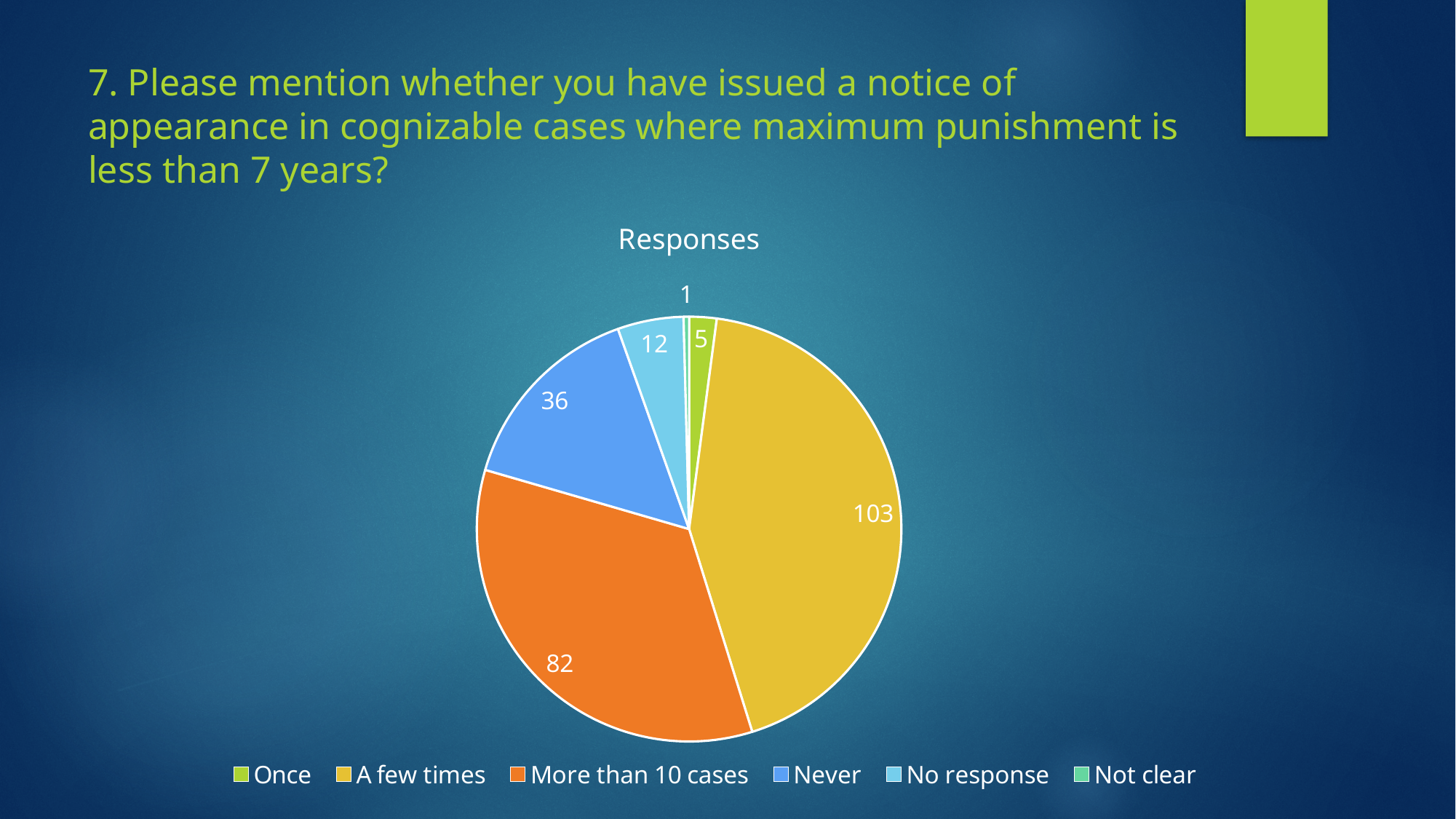
How many responses are in the 'Never' category? 36 How many responses are in the 'A few times' category? 103 How many responses are in the 'More than 10 cases' category? 82 Which category has the largest slice of the pie? A few times Which is larger, 'Never' or 'No response'? Never What is the difference between the 'A few times' and 'More than 10 cases' values? 21 What is the title of the chart? Responses How many responses are in the 'No response' category? 12 What type of chart is shown on the slide? pie chart How many categories does the legend list? 6 Which category has the smallest slice of the pie? Not clear How many responses are in the 'Once' category? 5